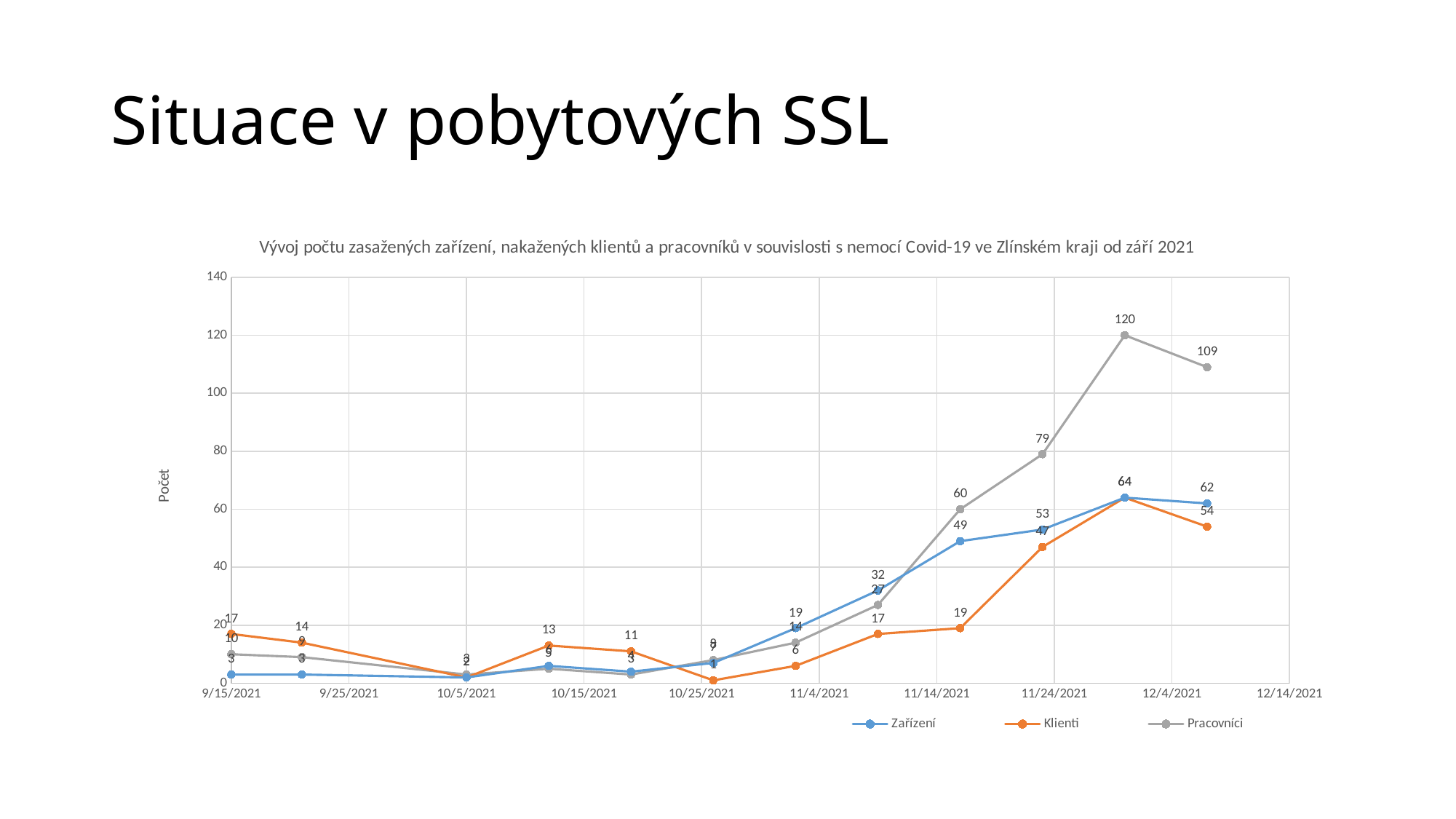
What is the difference between the peak value of Pracovníci (120) and its final value (109)? 11 What kind of chart is shown on the slide? line chart At the rightmost data point, which series has the larger value: Zařízení or Klienti? Zařízení Is the final value of the Pracovníci series greater or less than 100? greater What is the highest value reached by the Klienti series? 64 What is the highest value reached by the Zařízení series? 64 What is the value of the rightmost (final) data point of the Pracovníci series? 109 How many series does the legend list? 3 Do the values of the Zařízení series generally rise or fall from September to December 2021? rise What is the label of the vertical axis? Počet What is the highest value reached by the Pracovníci series? 120